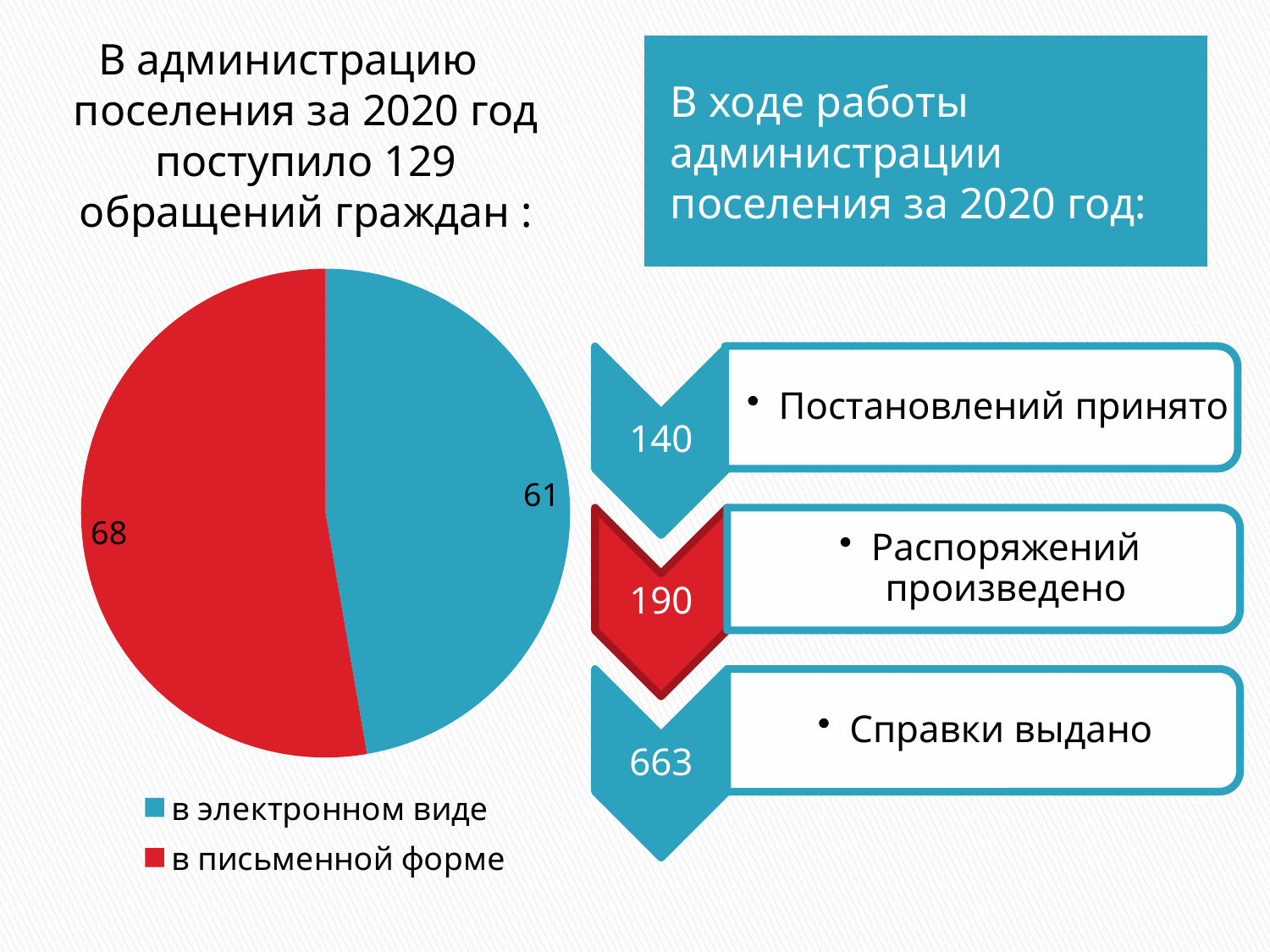
Which is larger: the value for "в электронном виде" or "в письменной форме"? в письменной форме Which category has the smallest slice in the pie chart? в электронном виде What type of chart is shown on the slide? pie chart What is the difference between the values for "в письменной форме" and "в электронном виде"? 7 How many slices does the pie chart have? 2 What is the value for "в электронном виде" in the pie chart? 61 What colour is the slice for "в письменной форме"? red What is the total of the two slices in the pie chart? 129 Which category has the largest slice in the pie chart? в письменной форме What is the value for "в письменной форме" in the pie chart? 68 What colour is the slice for "в электронном виде"? blue How many entries does the legend of the pie chart list? 2